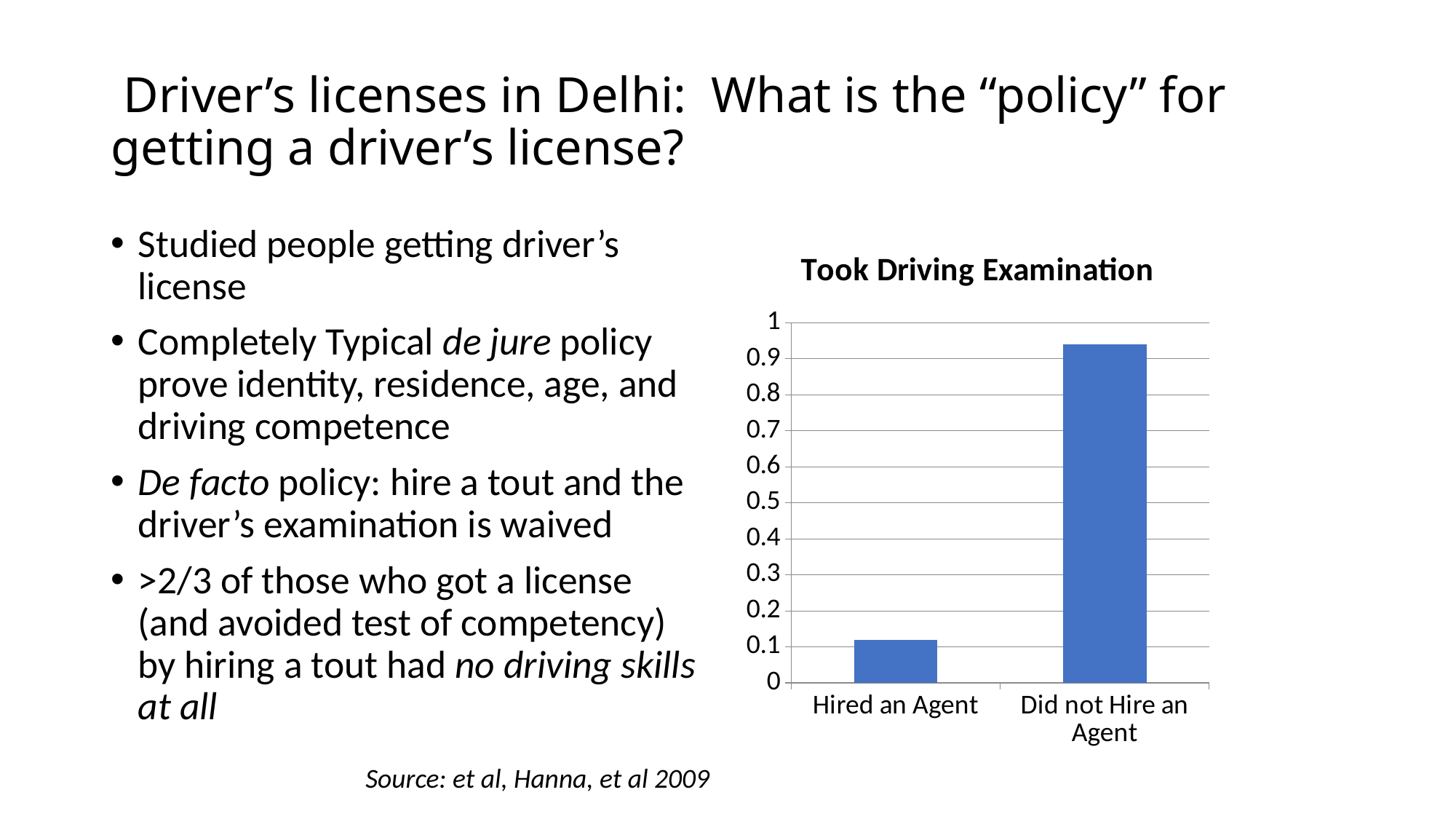
What is the title of the chart? Took Driving Examination Is the value for Did not Hire an Agent greater or less than 1? less What is the maximum value shown on the chart's y axis? 1 Which category has the lowest value in the chart? Hired an Agent Is the value for Hired an Agent greater or less than 0.2? less Which category has the highest value in the chart? Did not Hire an Agent Is the value for Did not Hire an Agent greater or less than 0.9? greater Do the bar values rise or fall from left to right along the x axis? rise How many categories are shown on the chart's x axis? 2 What type of chart is shown on the slide? bar chart Which is larger: the value for Hired an Agent or the value for Did not Hire an Agent? Did not Hire an Agent